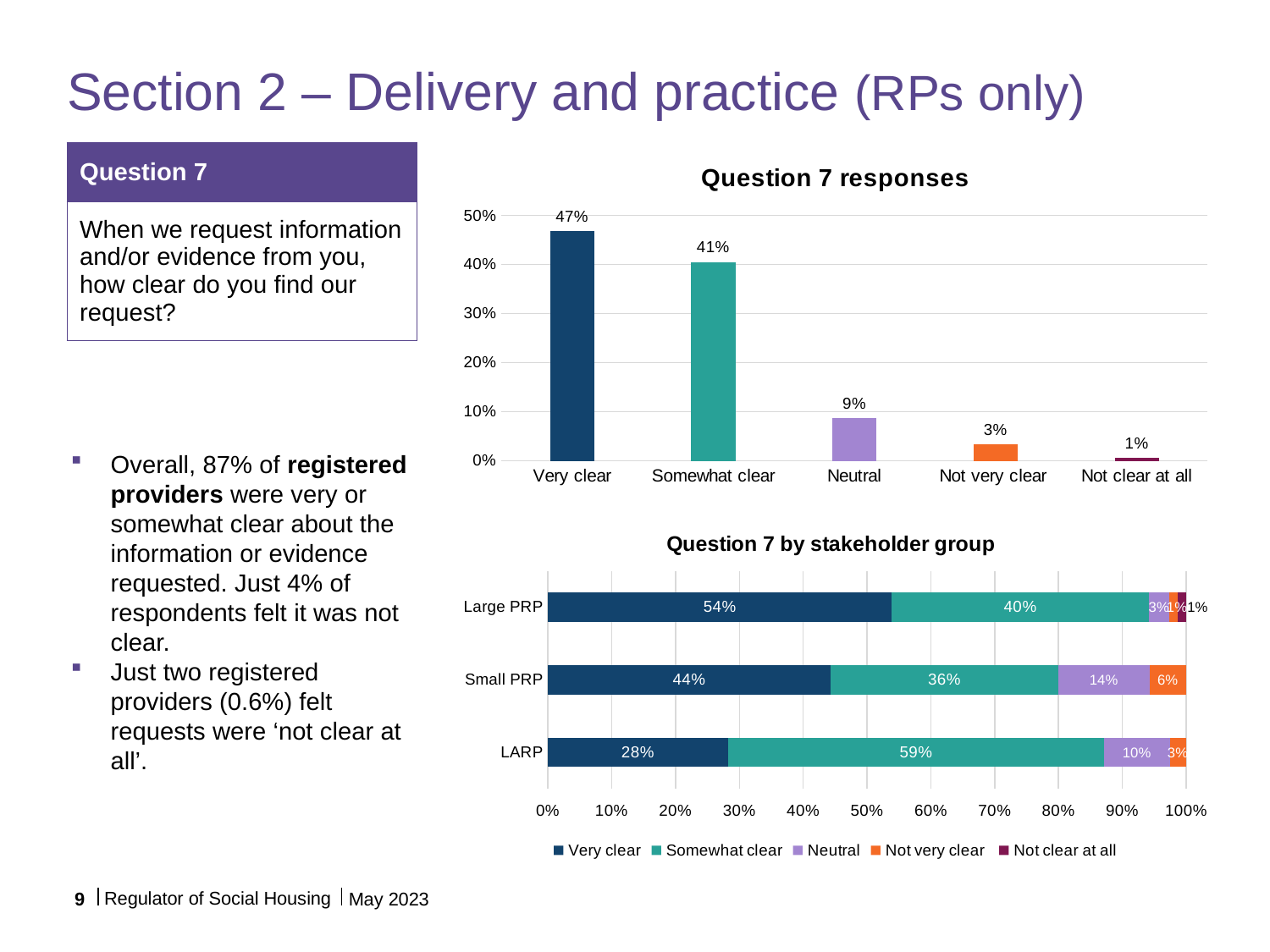
In the 'Question 7 responses' chart, what is the difference between 'Very clear' and 'Somewhat clear'? 6% In the 'Question 7 by stakeholder group' chart, what is the 'Somewhat clear' value for LARP? 59% In the 'Question 7 responses' chart, do the values rise or fall from left to right along the x axis? Fall In the 'Question 7 by stakeholder group' chart, what is the 'Very clear' value for Small PRP? 44% In the 'Question 7 responses' chart, which category has the lowest value? Not clear at all How many series does the legend of the 'Question 7 by stakeholder group' chart list? 5 In the 'Question 7 responses' chart, what is the value for 'Neutral'? 9% In the 'Question 7 responses' chart, how many response categories are shown on the x axis? 5 In the 'Question 7 responses' chart, what percentage of respondents answered 'Very clear'? 47% In the 'Question 7 by stakeholder group' chart, which stakeholder group has the highest 'Very clear' share? Large PRP In the 'Question 7 by stakeholder group' chart, is the 'Neutral' value larger for Small PRP or LARP? Small PRP What type of chart is the 'Question 7 responses' chart? Bar chart